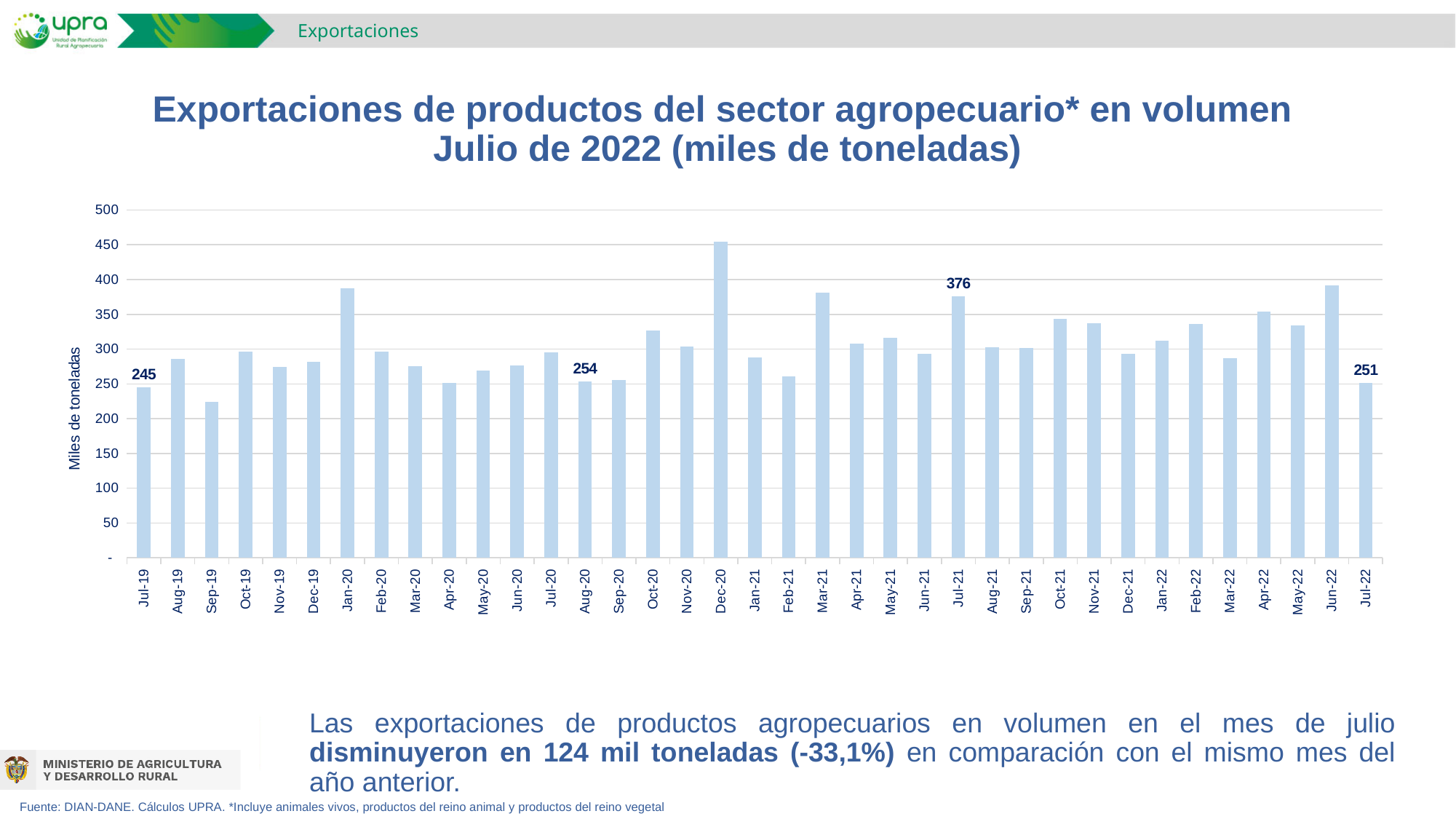
Which month has the highest value? Dec-20 What is the value for Jul-19? 245 Is the value for Sep-19 greater or less than 250? less What is the value for Jul-21? 376 What is the value for Aug-20? 254 Which month has the lowest value? Sep-19 Is the value for Dec-20 greater or less than 400? greater What kind of chart is this? bar chart Which is larger, the value for Jul-21 or the value for Jul-22? Jul-21 What is the value for Jul-22? 251 What is the difference between the values for Aug-20 and Jul-19? 9 How many months are shown on the x axis? 37